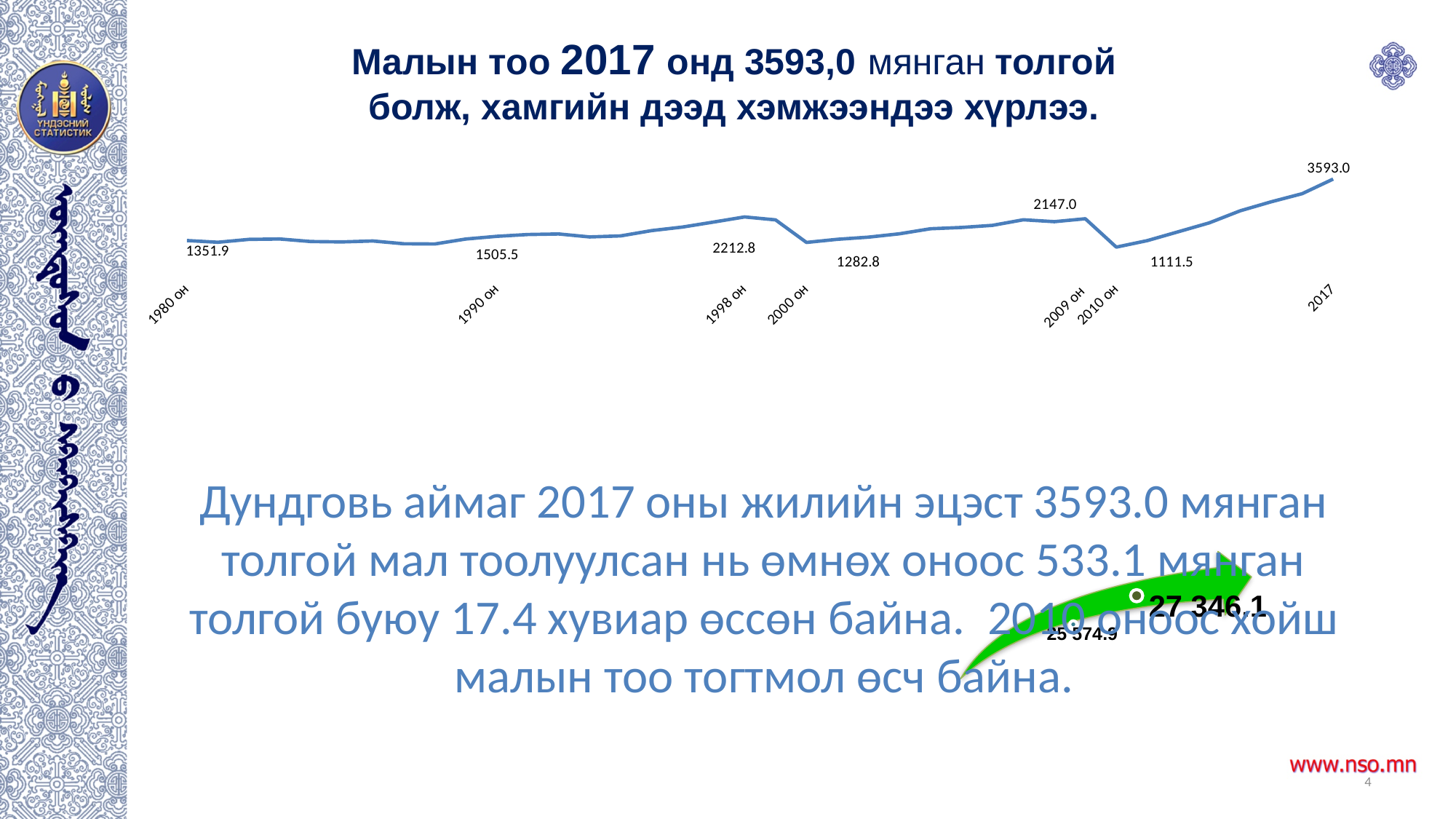
What is the difference between the values for 2017 and 2010 он? 2481.5 What is the value labelled for 1980 он? 1351.9 Which is larger, the value for 1998 он or the value for 2009 он? 1998 он What is the value labelled for 1990 он? 1505.5 What is the value labelled for 2017? 3593.0 What is the value labelled for 2010 он? 1111.5 Which labelled year has the lowest value on the line chart? 2010 он What is the value labelled for 2000 он? 1282.8 Which labelled year has the highest value on the line chart? 2017 What is the value labelled for 1998 он? 2212.8 What type of chart is shown on the slide? line chart What is the value labelled for 2009 он? 2147.0